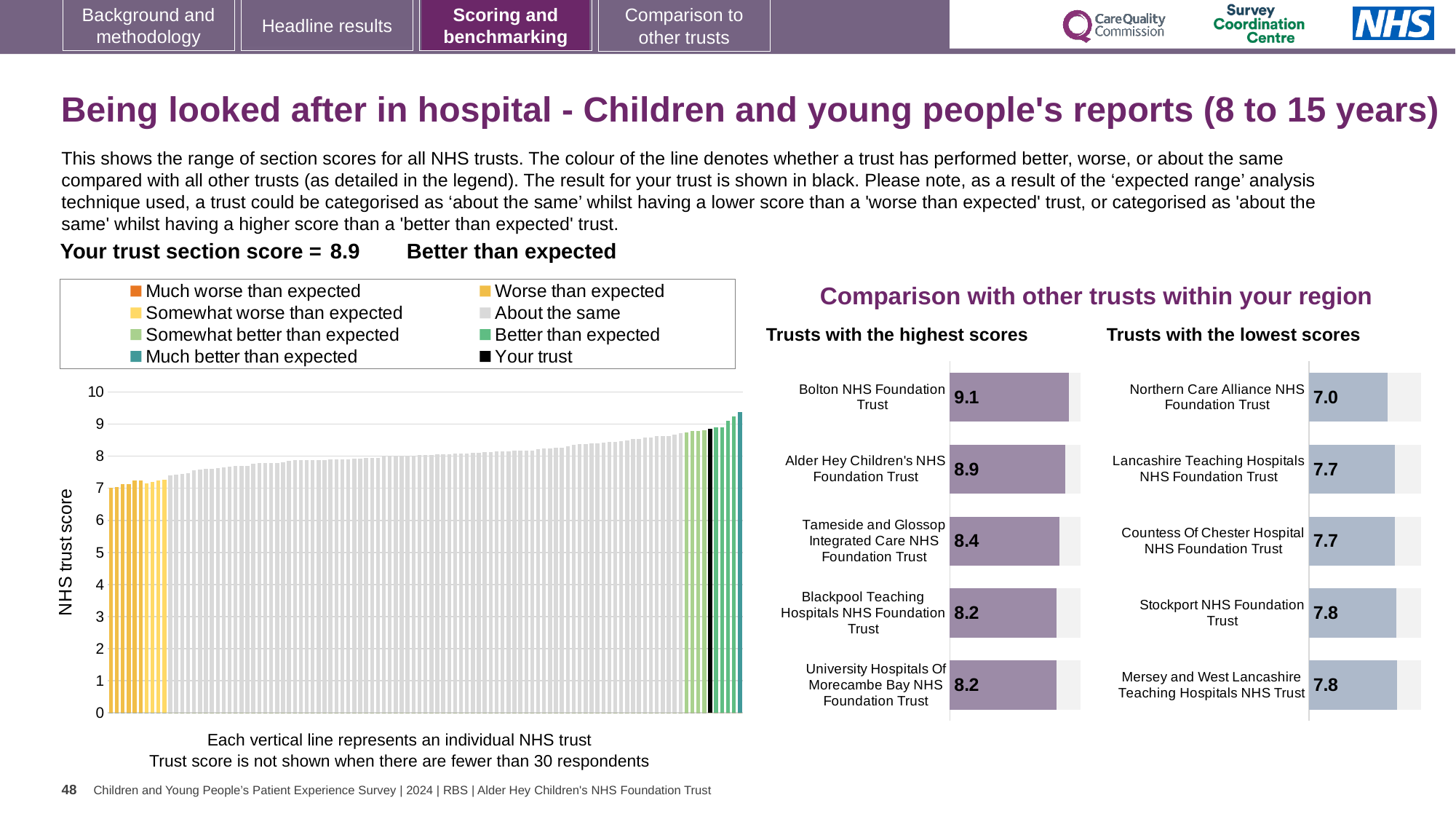
What type of chart is the large chart on the left showing NHS trust scores? Bar chart In the large chart on the left, do the NHS trust scores rise or fall from left to right? Rise In the 'Trusts with the highest scores' chart, which has the larger score: Alder Hey Children's NHS Foundation Trust or Blackpool Teaching Hospitals NHS Foundation Trust? Alder Hey Children's NHS Foundation Trust In the 'Trusts with the lowest scores' chart, what is the score for Northern Care Alliance NHS Foundation Trust? 7.0 In the 'Trusts with the lowest scores' chart, what is the difference between the scores of Stockport NHS Foundation Trust and Northern Care Alliance NHS Foundation Trust? 0.8 In the 'Trusts with the highest scores' chart, what is the difference between the scores of Bolton NHS Foundation Trust and Alder Hey Children's NHS Foundation Trust? 0.2 How many trusts are shown in the 'Trusts with the lowest scores' chart? 5 In the 'Trusts with the highest scores' chart, what is the score for Tameside and Glossop Integrated Care NHS Foundation Trust? 8.4 In the 'Trusts with the highest scores' chart, which trust has the highest score? Bolton NHS Foundation Trust In the 'Trusts with the lowest scores' chart, which trust has the lowest score? Northern Care Alliance NHS Foundation Trust In the 'Trusts with the highest scores' chart, what is the score for Bolton NHS Foundation Trust? 9.1 In the 'Trusts with the lowest scores' chart, what is the score for Stockport NHS Foundation Trust? 7.8